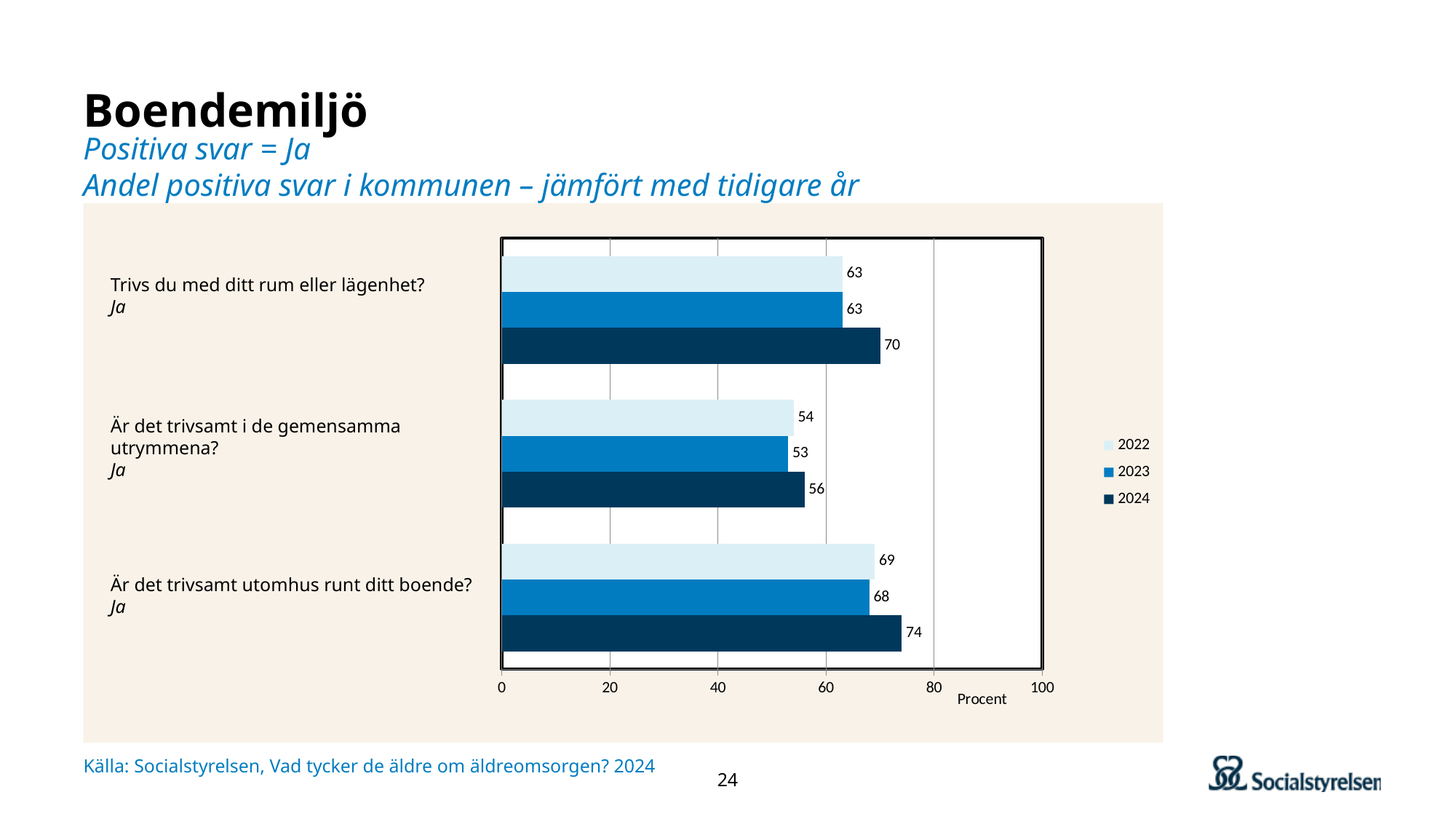
How many series does the legend list? 3 Which question has the highest 2024 value? Är det trivsamt utomhus runt ditt boende? Which question has the lowest 2022 value? Är det trivsamt i de gemensamma utrymmena? Is the 2024 value for "Är det trivsamt i de gemensamma utrymmena?" greater or less than 60? less What is the 2023 value for "Är det trivsamt i de gemensamma utrymmena?"? 53 For "Är det trivsamt utomhus runt ditt boende?", which year has the larger value, 2022 or 2023? 2022 What is the 2022 value for "Är det trivsamt utomhus runt ditt boende?"? 69 What label is shown on the horizontal axis of the chart? Procent How many questions (categories) are shown in the chart? 3 What is the 2024 value for "Trivs du med ditt rum eller lägenhet?"? 70 What is the difference between the 2024 and 2023 values for "Trivs du med ditt rum eller lägenhet?"? 7 What kind of chart is shown on the slide? bar chart